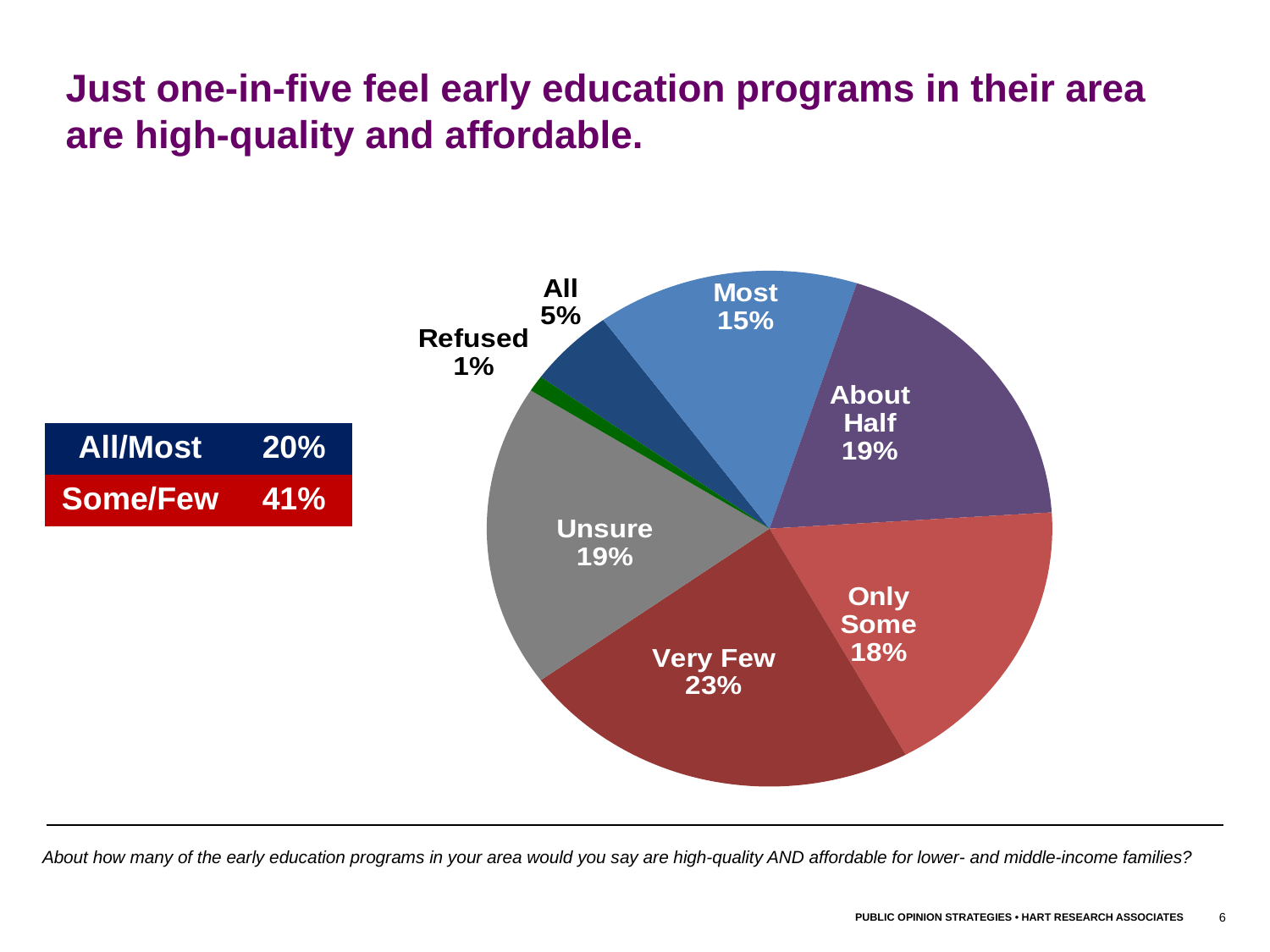
Which is larger, the "Unsure" slice or the "Most" slice? Unsure What percentage of respondents said "About Half"? 19% What kind of chart is shown on the slide? Pie chart What percentage of respondents said "Most"? 15% What percentage of respondents refused to answer? 1% What combined percentage does the slide give for "Some/Few"? 41% How many slices does the pie chart have? 7 What percentage of respondents said "Very Few"? 23% What percentage of respondents said "Only Some"? 18% Which slice of the pie chart is the largest? Very Few What is the difference in percentage points between "Very Few" and "All"? 18 Which slice of the pie chart is the smallest? Refused